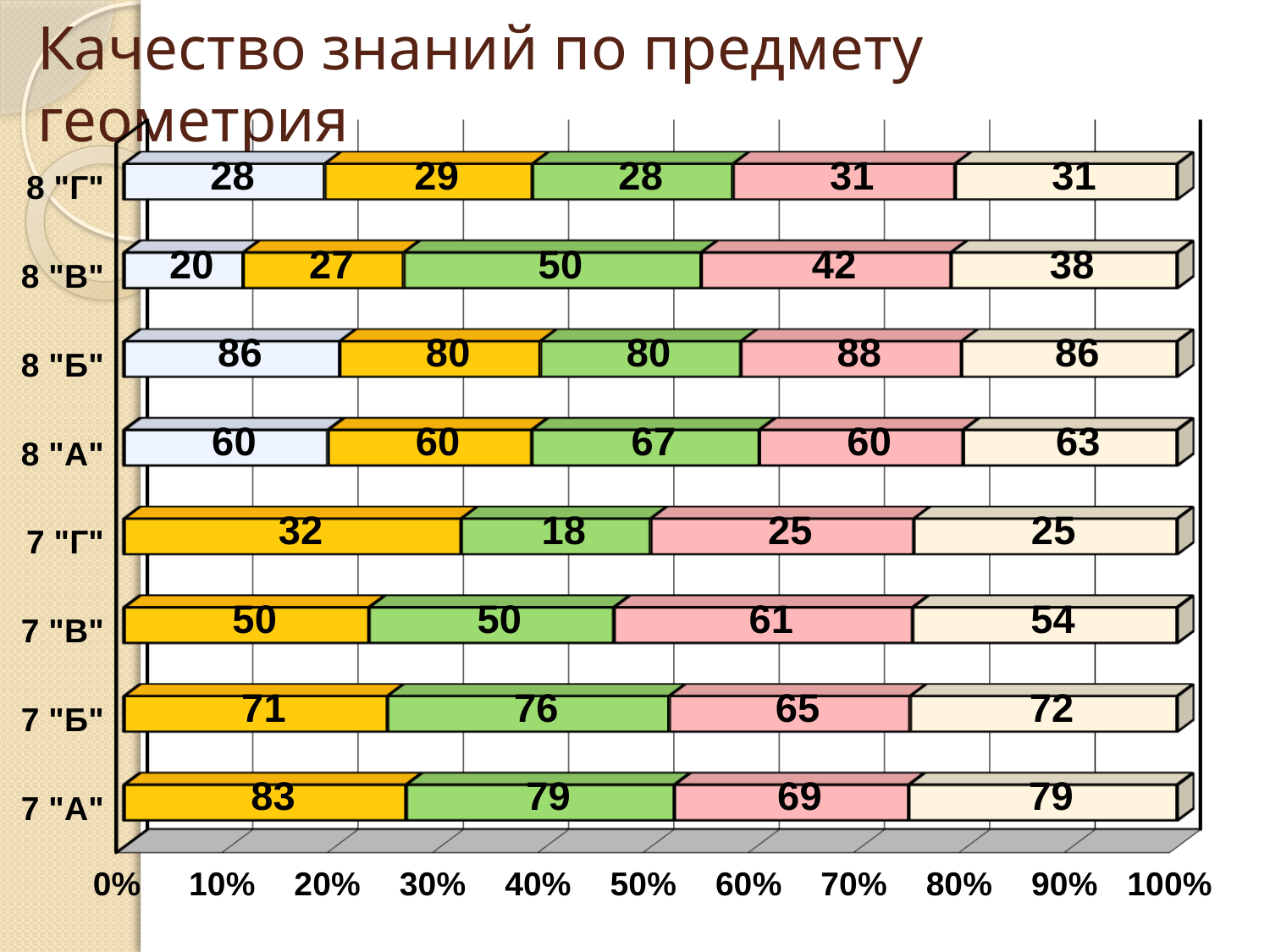
What is the title of the chart? Качество знаний по предмету геометрия What is the difference between the pink segment and the green segment for 7 "В"? 11 What is the difference between the green segment and the yellow segment for 8 "В"? 23 What is the value of the cream (last) segment for 7 "Б"? 72 What is the value of the green segment for 8 "В"? 50 What is the value of the pink segment for 8 "Б"? 88 How many coloured segments make up the bar for 8 "А"? 5 What kind of chart is shown on the slide? bar chart How many classes (categories) are shown on the vertical axis? 8 What is the value of the light blue segment for 8 "В"? 20 Which is larger for 7 "Г": the yellow segment or the green segment? yellow segment What is the value of the yellow segment for 7 "А"? 83